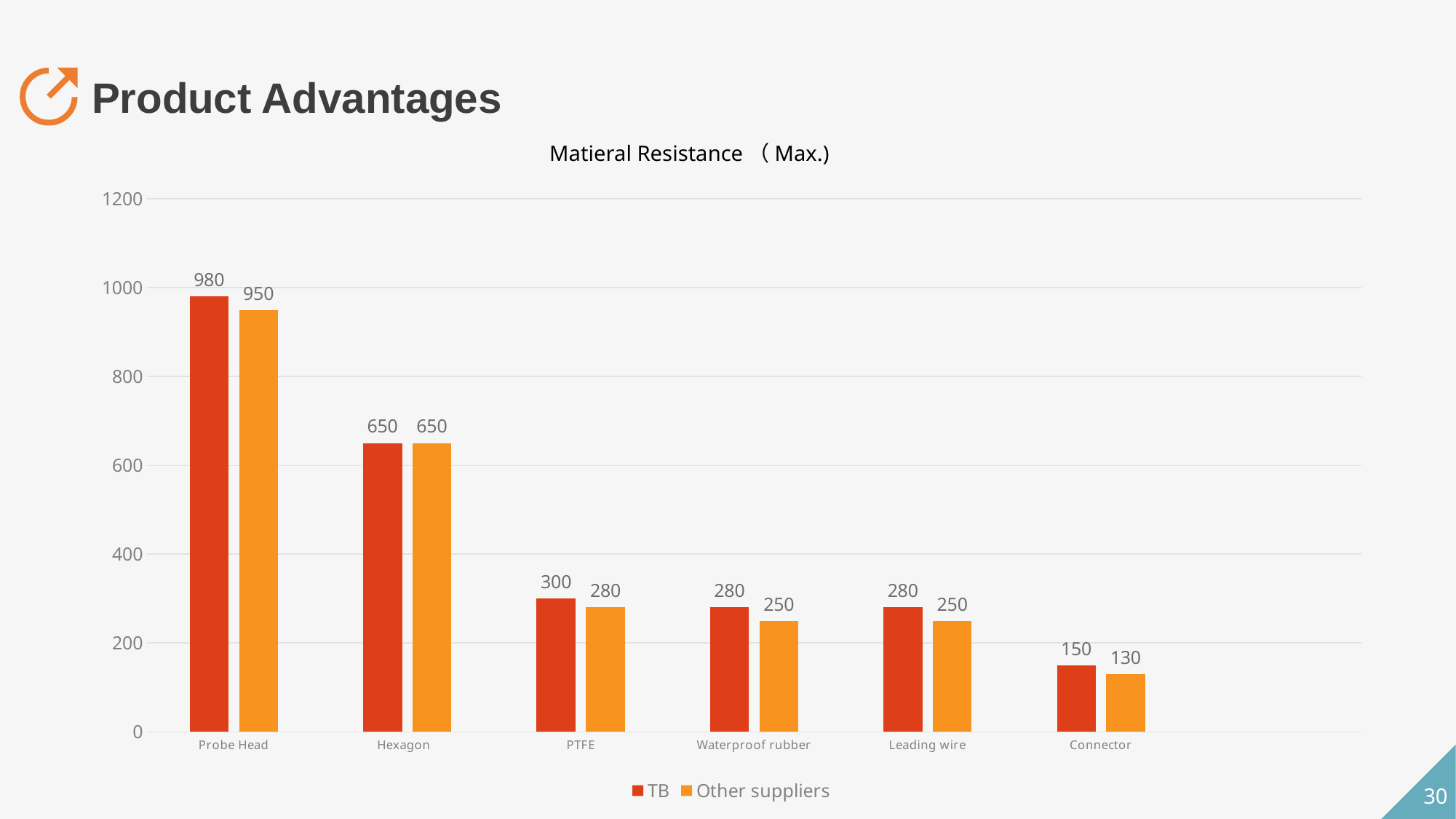
What is the difference between the TB value for Hexagon and the TB value for PTFE? 350 Which category has the highest TB value? Probe Head How many series does the legend list? 2 What is the difference between the TB and Other suppliers values for Probe Head? 30 What is the TB value for Probe Head? 980 What is the Other suppliers value for Connector? 130 What kind of chart is shown on the slide? Bar chart Which is larger for Leading wire, the TB value or the Other suppliers value? TB Which category has the lowest Other suppliers value? Connector How many categories are shown on the x axis? 6 What is the title of the chart? Matieral Resistance （Max.) What is the Other suppliers value for Waterproof rubber? 250